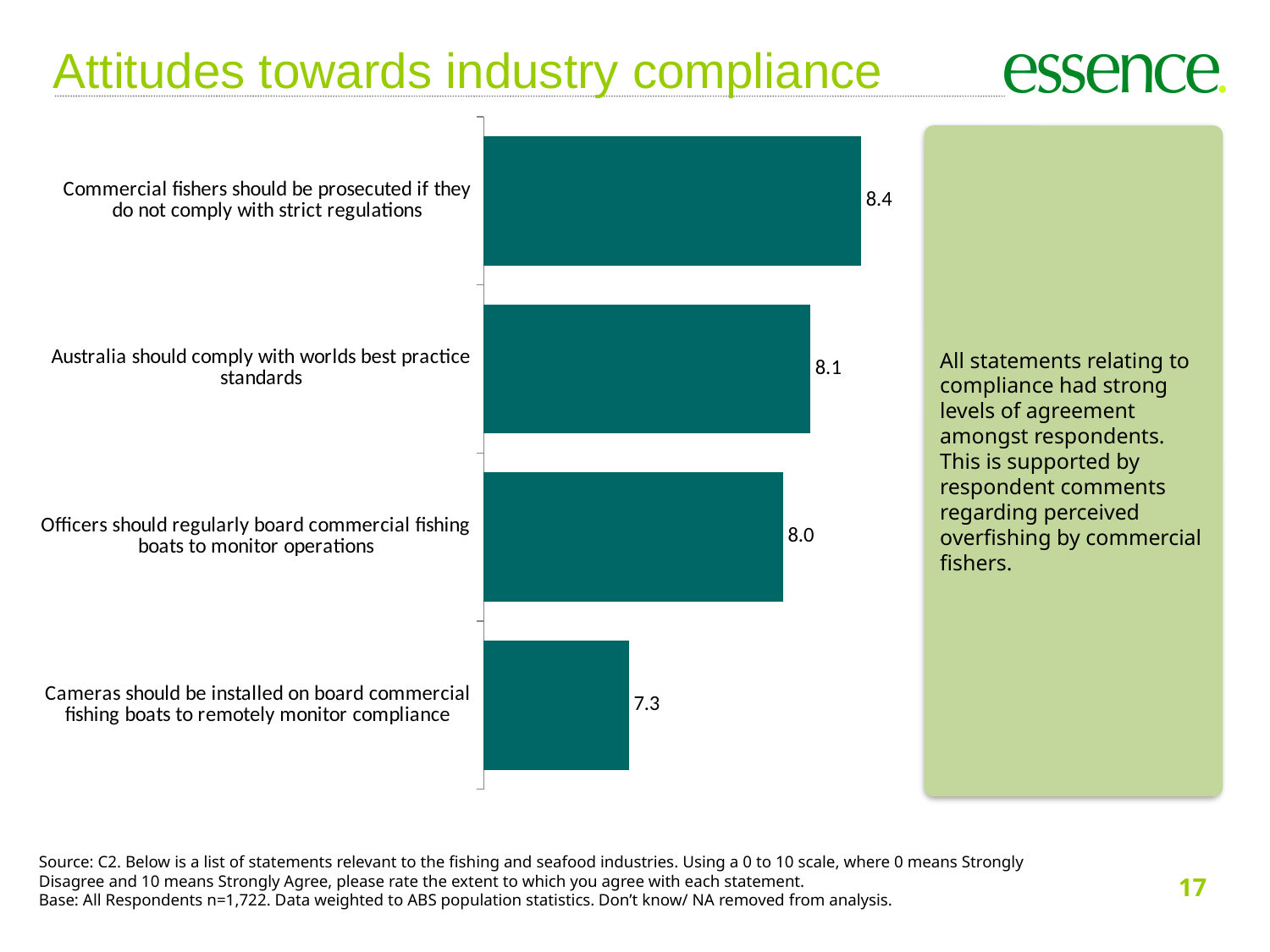
What is the value for "Cameras should be installed on board commercial fishing boats to remotely monitor compliance"? 7.3 What is the value for "Commercial fishers should be prosecuted if they do not comply with strict regulations"? 8.4 Which statement has the highest value? Commercial fishers should be prosecuted if they do not comply with strict regulations What is the value for "Australia should comply with worlds best practice standards"? 8.1 How many statements are shown in the chart? 4 What kind of chart is shown on the slide? Bar chart What is the difference between the value for "Commercial fishers should be prosecuted if they do not comply with strict regulations" and the value for "Cameras should be installed on board commercial fishing boats to remotely monitor compliance"? 1.1 What is the value for "Officers should regularly board commercial fishing boats to monitor operations"? 8.0 Which statement has the lowest value? Cameras should be installed on board commercial fishing boats to remotely monitor compliance What is the title of the slide containing the chart? Attitudes towards industry compliance Which has a larger value: "Australia should comply with worlds best practice standards" or "Cameras should be installed on board commercial fishing boats to remotely monitor compliance"? Australia should comply with worlds best practice standards What is the difference between the value for "Australia should comply with worlds best practice standards" and the value for "Officers should regularly board commercial fishing boats to monitor operations"? 0.1